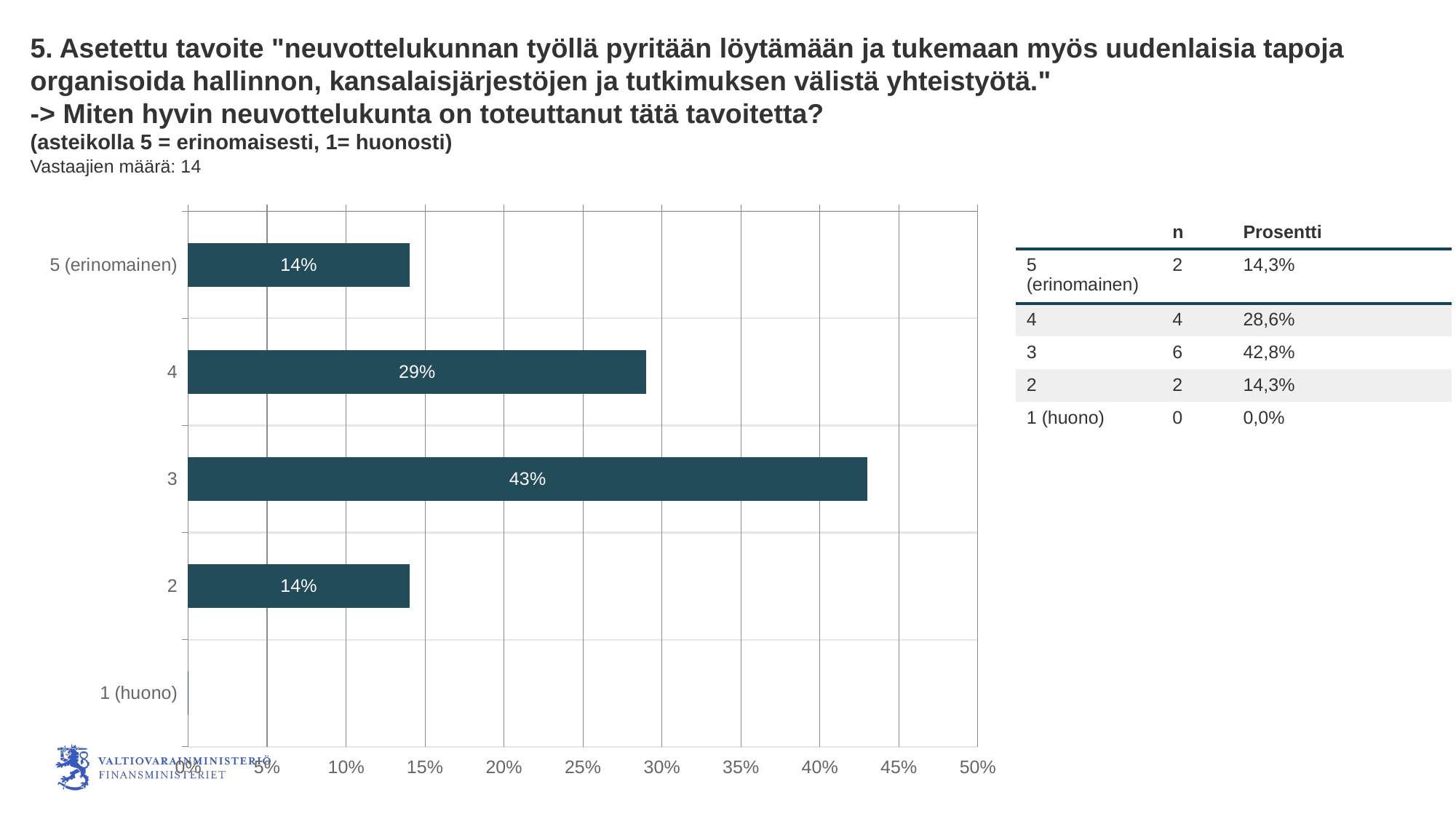
What kind of chart is shown on the slide? bar chart What is the difference between the values for category 3 and category 4? 14% What is the maximum value shown on the x axis? 50% What is the value shown for category 4? 29% How many respondents (Vastaajien määrä) are reported on the slide? 14 How many categories are shown on the chart? 5 Which category has the lowest value? 1 (huono) What is the value shown for category 3? 43% Is the value for category 3 greater or less than 40%? greater Which is larger, the value for category 4 or the value for category 2? 4 Which category has the highest value? 3 What is the value shown for category 5 (erinomainen)? 14%